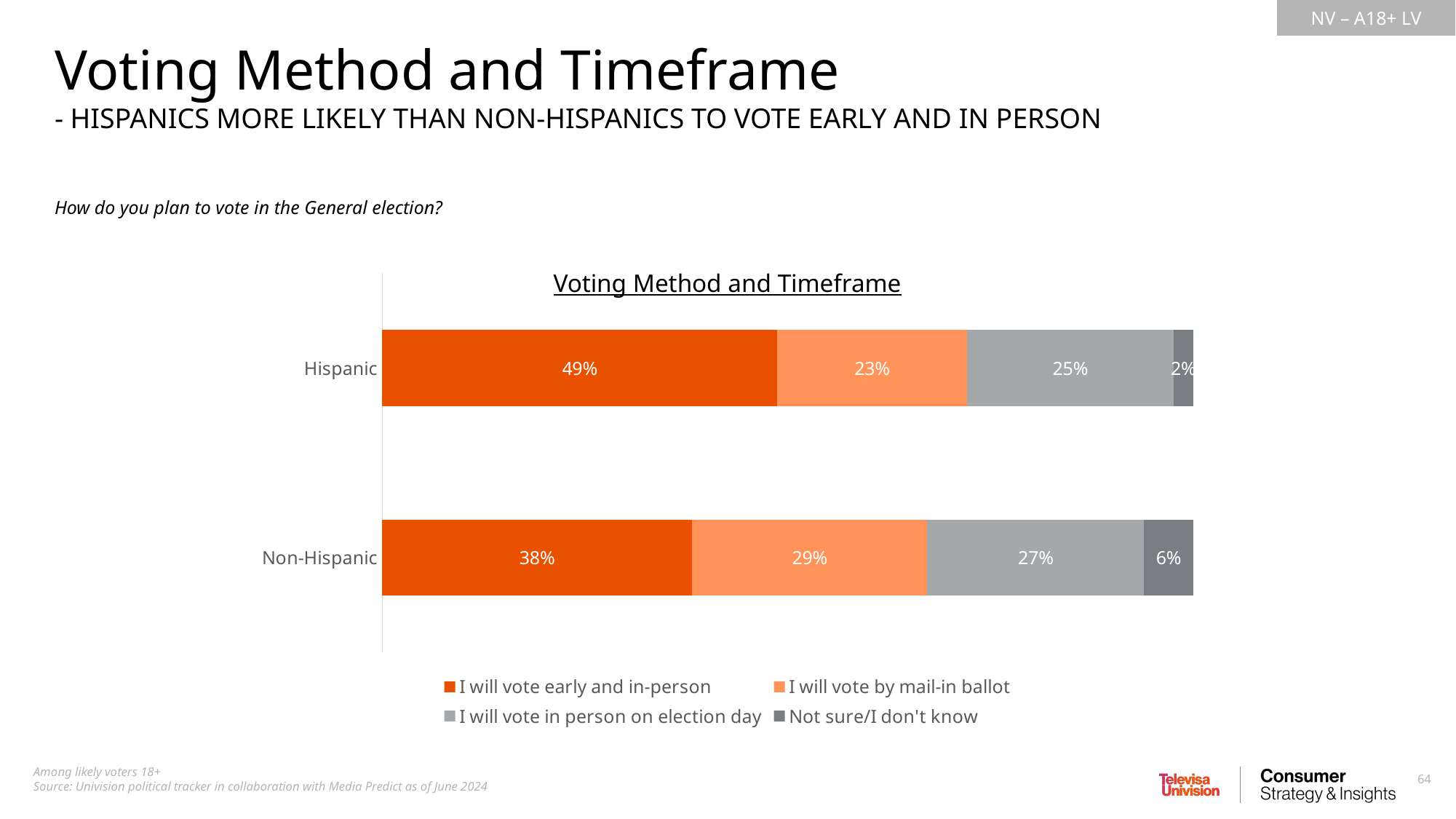
What percentage of Hispanic likely voters say they will vote in person on election day? 25% Which response has the smallest share among Hispanic likely voters? Not sure/I don't know What type of chart is shown on the slide? Stacked bar chart Which group has the higher share saying they will vote early and in-person, Hispanic or Non-Hispanic? Hispanic What percentage of Hispanic likely voters say they will vote early and in-person? 49% What percentage of Non-Hispanic likely voters are not sure or don't know how they will vote? 6% How many series does the legend list? 4 How many groups (categories) are shown on the chart? 2 What is the difference in percentage points between Non-Hispanic and Hispanic voters who will vote by mail-in ballot? 6 Which voting method has the largest share among Non-Hispanic likely voters? I will vote early and in-person What is the difference in percentage points between Hispanic and Non-Hispanic voters who will vote early and in-person? 11 What percentage of Non-Hispanic likely voters say they will vote by mail-in ballot? 29%